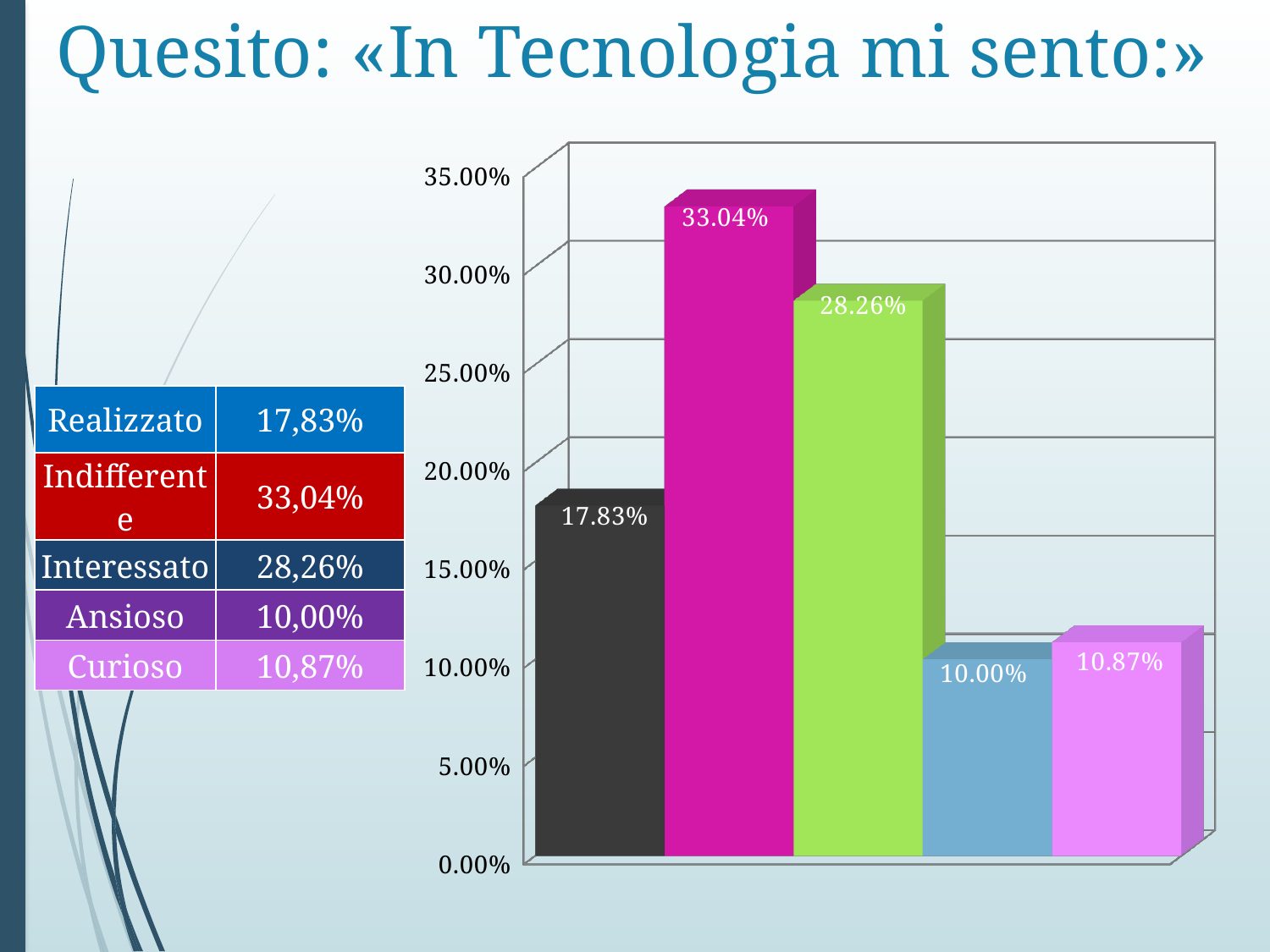
What is the value shown on the shortest bar in the chart? 10.00% What kind of chart is shown on the slide? bar chart What is the difference between the magenta bar (33.04%) and the green bar (28.26%)? 4.78% What is the value shown on the tallest bar in the chart? 33.04% What value is printed on the first (black) bar of the chart? 17.83% Which is larger, the value of the black bar or the value of the light blue bar? the black bar According to the table, which category corresponds to the 33,04% value? Indifferente What is the highest tick value shown on the vertical axis of the chart? 35.00% Is the value of the green bar greater or less than 25.00%? greater How many bars are plotted in the chart? 5 What value is printed on the last (light purple) bar of the chart? 10.87% What value is printed on the green bar of the chart? 28.26%